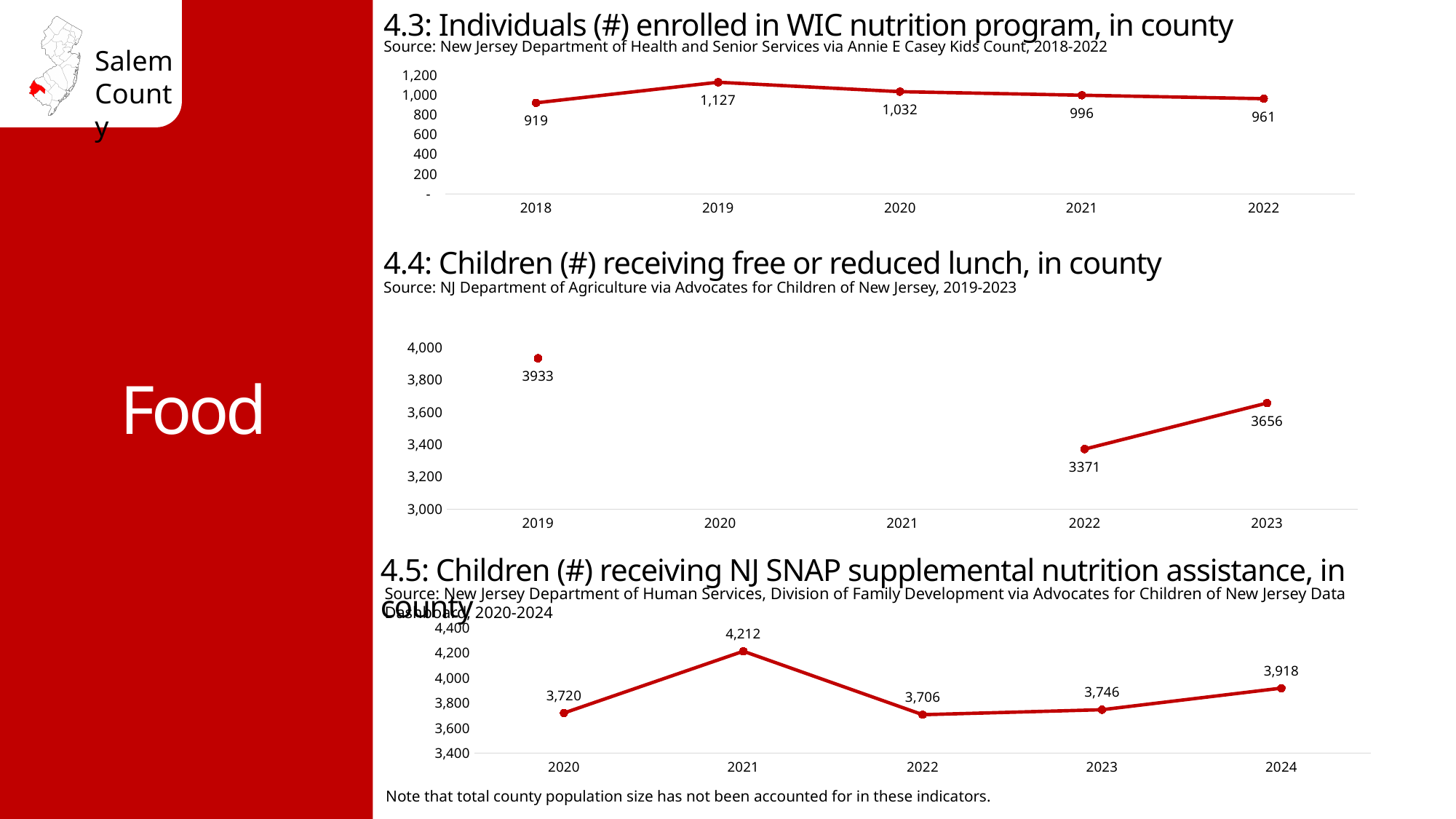
In the chart '4.3: Individuals (#) enrolled in WIC nutrition program, in county', which year has the lowest value? 2018 In the chart '4.3: Individuals (#) enrolled in WIC nutrition program, in county', what is the difference between the 2019 and 2022 values? 166 What type of chart is '4.5: Children (#) receiving NJ SNAP supplemental nutrition assistance, in county'? line chart In the chart '4.4: Children (#) receiving free or reduced lunch, in county', what is the value for 2022? 3371 In the chart '4.5: Children (#) receiving NJ SNAP supplemental nutrition assistance, in county', which is larger, the value for 2020 or the value for 2024? 2024 In the chart '4.3: Individuals (#) enrolled in WIC nutrition program, in county', do the values rise or fall from 2019 to 2022? fall In the chart '4.3: Individuals (#) enrolled in WIC nutrition program, in county', how many years are plotted? 5 In the chart '4.3: Individuals (#) enrolled in WIC nutrition program, in county', what is the value for 2019? 1,127 In the chart '4.4: Children (#) receiving free or reduced lunch, in county', which year has the highest value? 2019 In the chart '4.4: Children (#) receiving free or reduced lunch, in county', how many data points are plotted? 3 In the chart '4.5: Children (#) receiving NJ SNAP supplemental nutrition assistance, in county', what is the difference between the 2021 and 2022 values? 506 In the chart '4.5: Children (#) receiving NJ SNAP supplemental nutrition assistance, in county', what is the value for 2021? 4,212